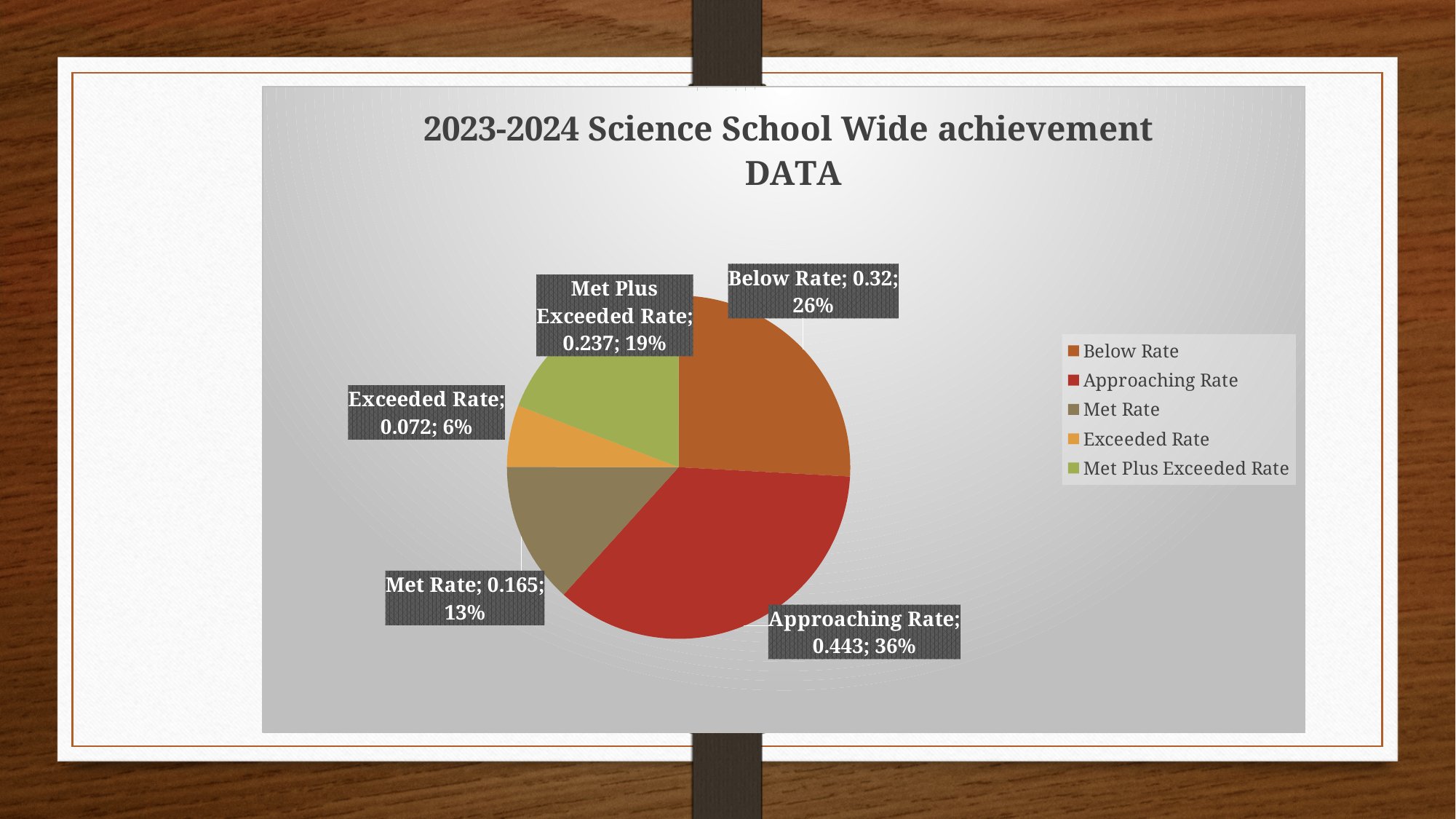
Which category has the largest slice? Approaching Rate What share of the pie does Approaching Rate represent? 36% Which category has the smallest slice? Exceeded Rate What is the value for Met Rate? 0.165 What is the value for Below Rate? 0.32 What is the difference between the values for Approaching Rate and Below Rate? 0.123 What share of the pie does Met Plus Exceeded Rate represent? 19% What is the title of the chart? 2023-2024 Science School Wide achievement DATA What type of chart is shown on the slide? pie chart What is the value for Exceeded Rate? 0.072 What is the value for Approaching Rate? 0.443 How many categories does the legend list? 5